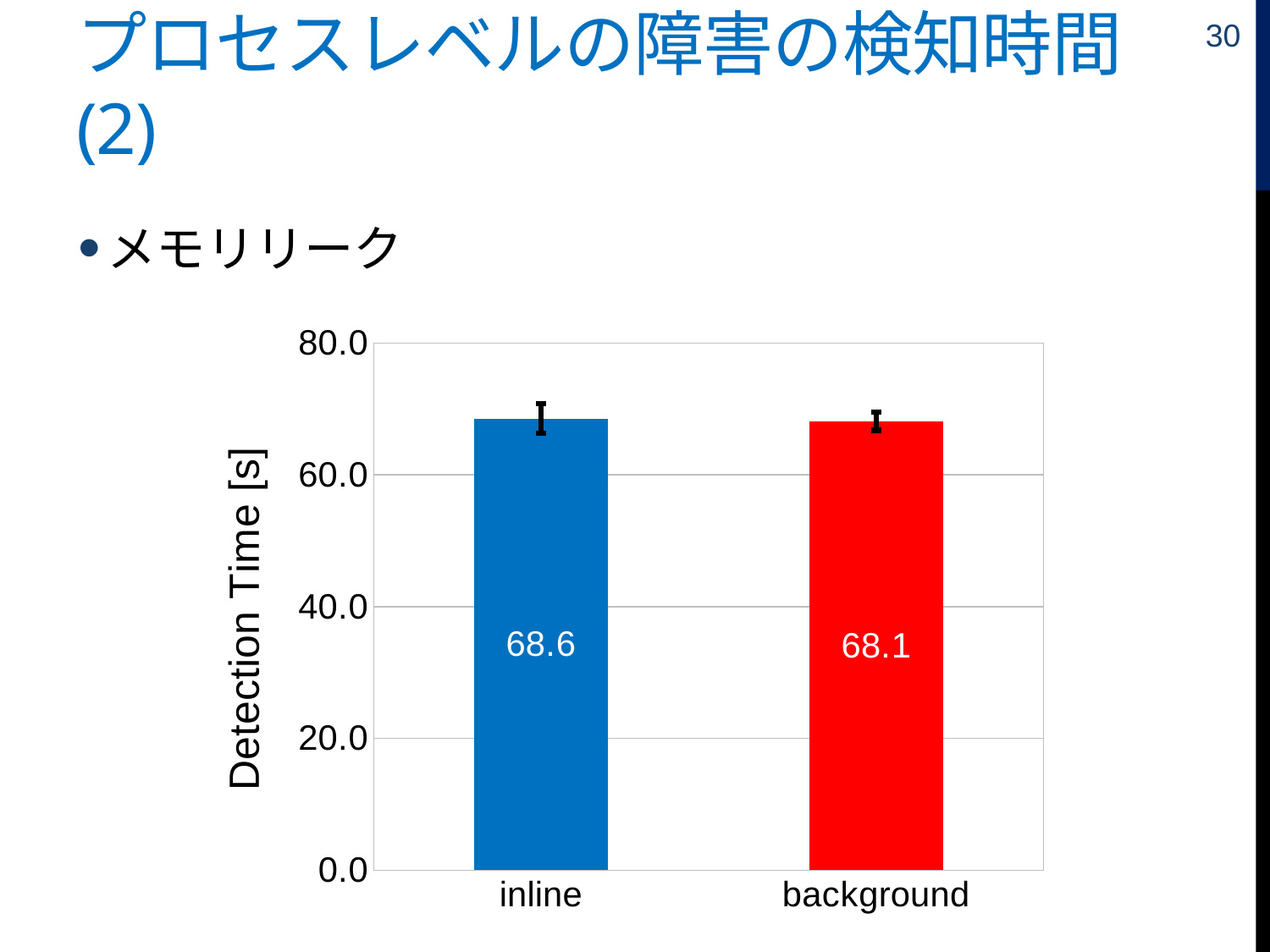
What is the detection time for inline? 68.6 Which category has the higher detection time, inline or background? inline How many categories are shown on the x axis? 2 What is the detection time for background? 68.1 What kind of chart is shown on the slide? bar chart Is the detection time for background greater or less than 80.0? less Is the detection time for inline greater or less than 60.0? greater Which category has the lowest detection time? background What colour is the bar for background? red What is the difference between the detection times for inline and background? 0.5 What is the label of the y axis? Detection Time [s]